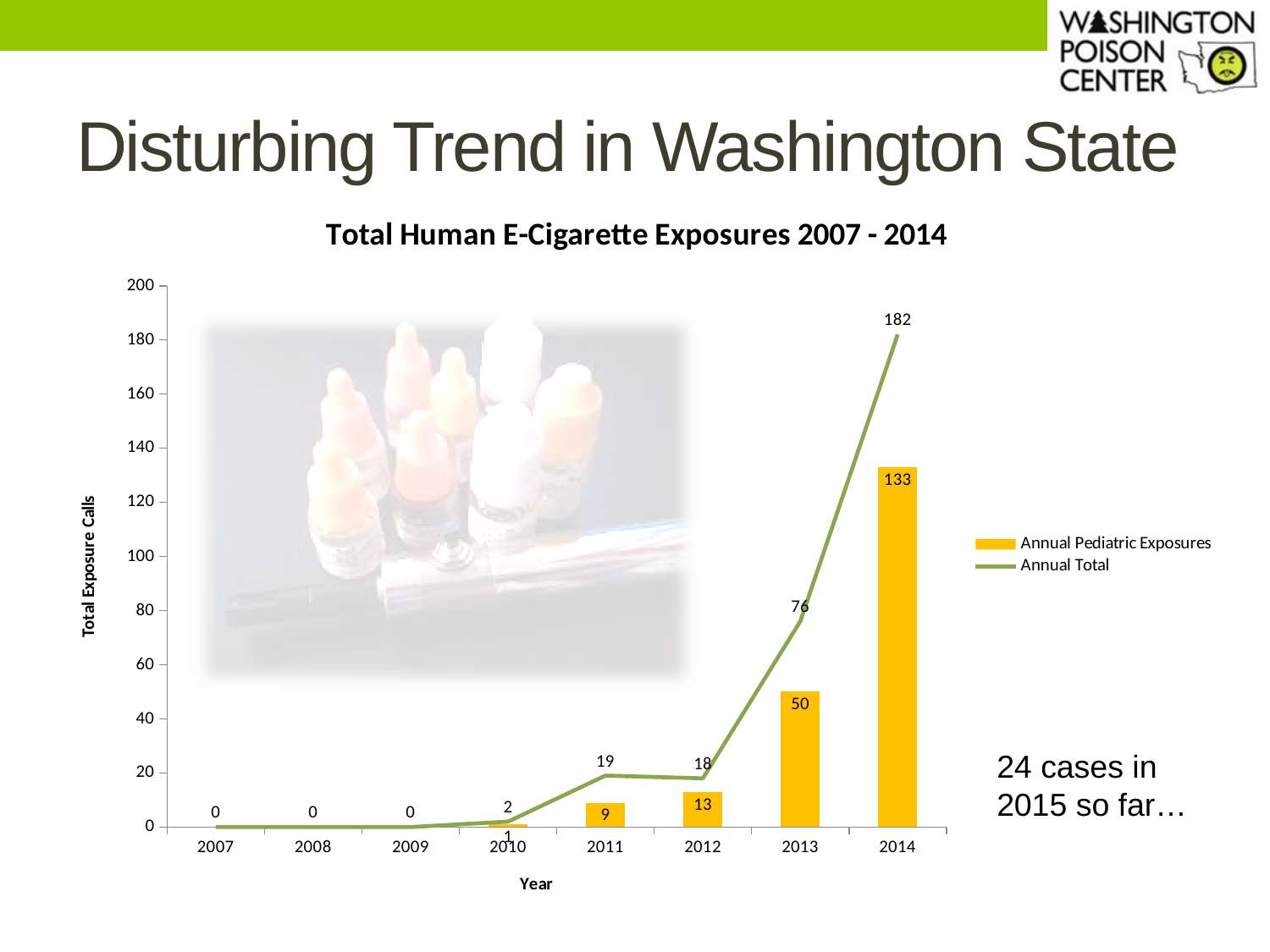
Which year has the highest Annual Total? 2014 What is the Annual Pediatric Exposures value for 2013? 50 What is the difference in Annual Total between 2013 and 2012? 58 Does the Annual Total generally rise or fall from 2007 to 2014? rise What is the Annual Pediatric Exposures value for 2014? 133 What is the difference between the Annual Total and the Annual Pediatric Exposures in 2014? 49 How many years are shown on the x axis? 8 What is the title of the chart? Total Human E-Cigarette Exposures 2007 - 2014 What is the Annual Total value for 2011? 19 How many series does the legend list? 2 Which is larger, the Annual Total for 2011 or for 2012? 2011 What is the Annual Total value for 2014? 182